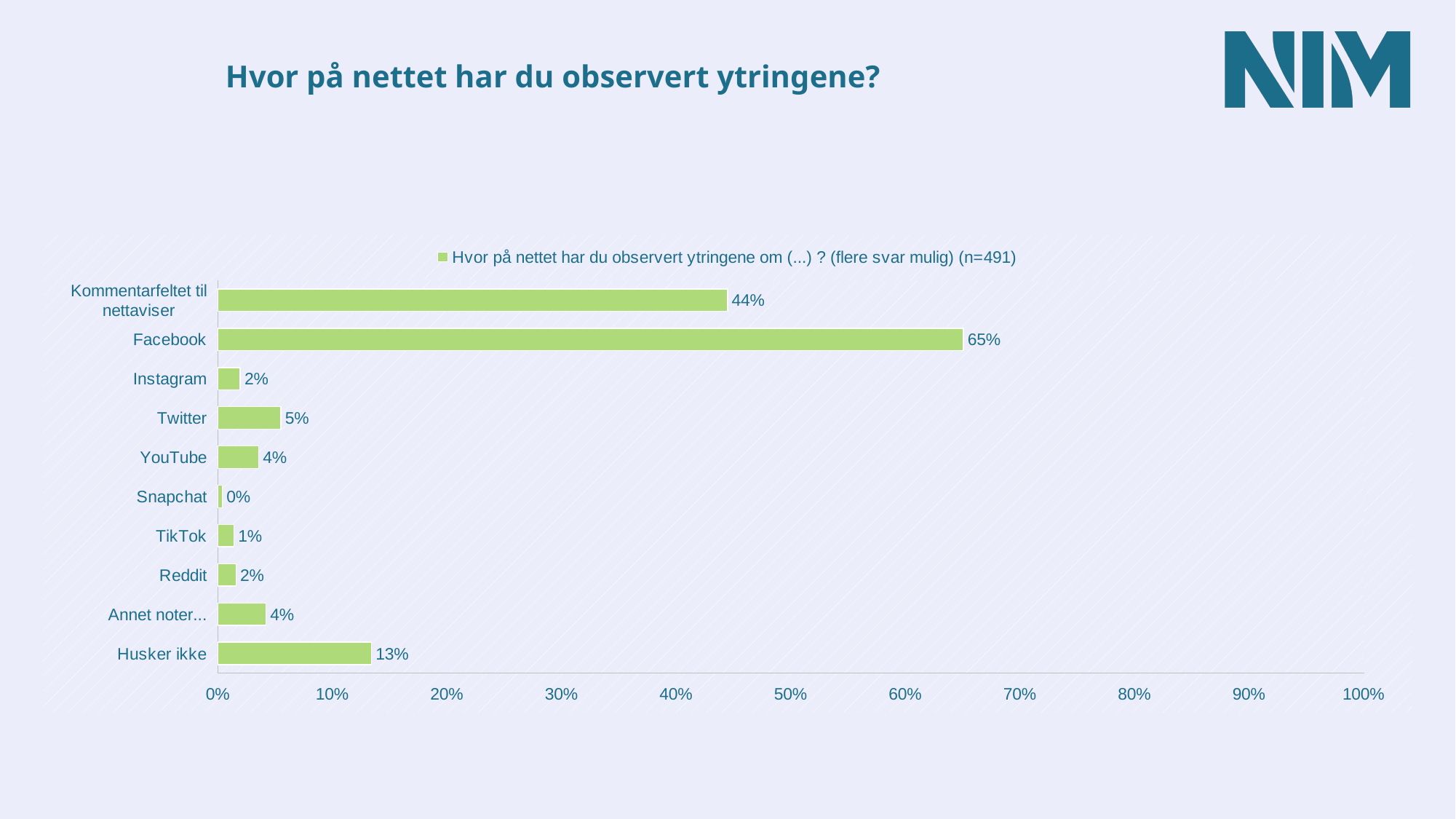
What kind of chart is shown on the slide? bar chart What is the value for Facebook? 65% What is the value for Husker ikke? 13% What is the difference between the values for Facebook and Kommentarfeltet til nettaviser? 21% How many categories are shown in the chart? 10 What is the value for Twitter? 5% What is the title of the slide? Hvor på nettet har du observert ytringene? Is the value for Facebook greater or less than 60%? greater Which is larger, the value for Twitter or the value for YouTube? Twitter Which category has the highest value? Facebook Which category has the lowest value? Snapchat What is the value for Kommentarfeltet til nettaviser? 44%